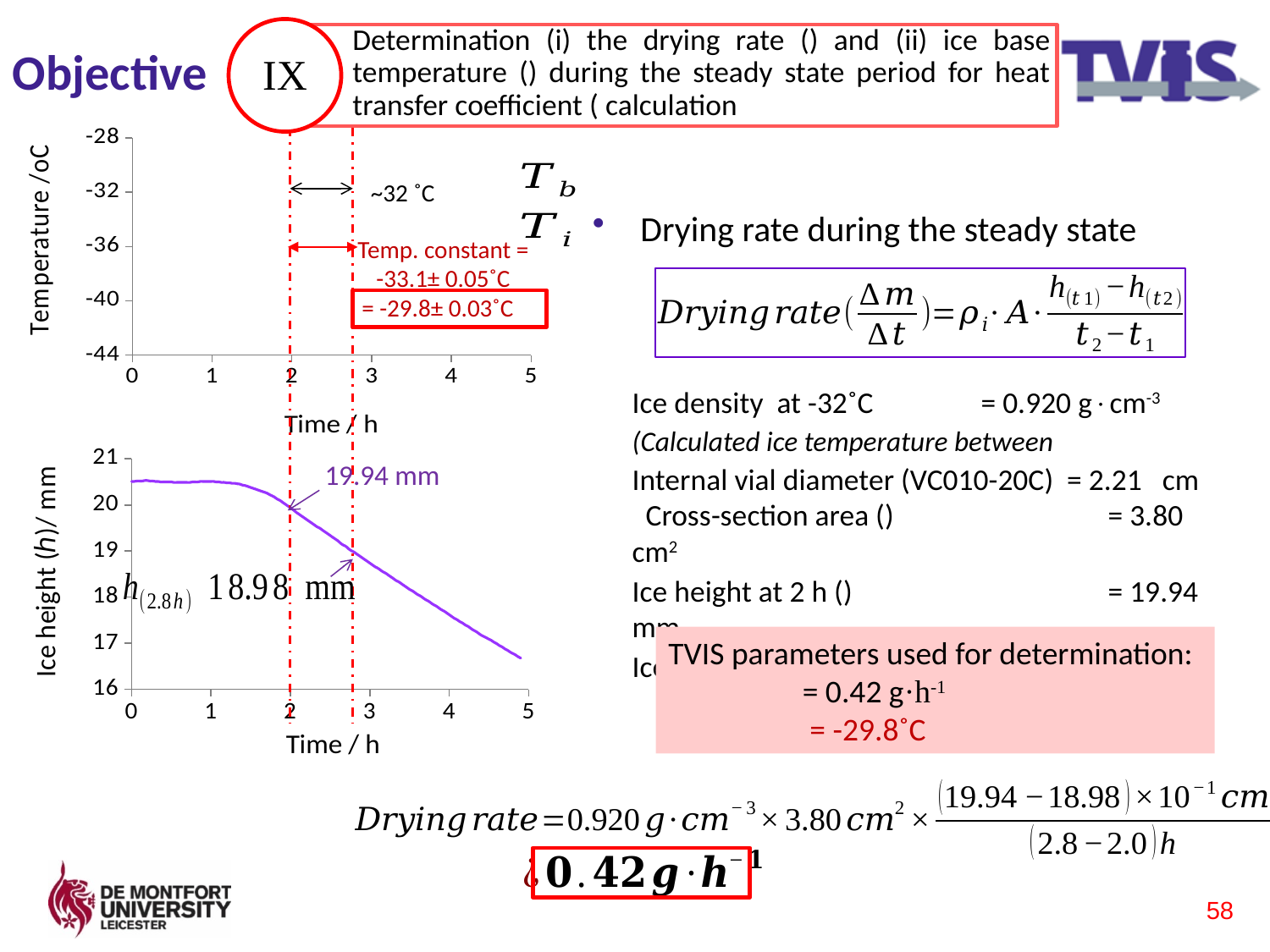
In the bottom chart (Ice height vs Time), is the ice height larger at 2 h or at 2.8 h? 2 h What is the y-axis label of the top chart? Temperature /oC In the bottom chart (Ice height vs Time), is the ice height at 4 h greater or less than 18? less In the bottom chart (Ice height vs Time), what is the ice height at 2 h? 19.94 mm In the bottom chart (Ice height vs Time), is the ice height at 1 h greater or less than 20? greater How many data series are plotted in the bottom chart (Ice height vs Time)? 1 What kind of chart is the bottom chart (Ice height vs Time)? line chart In the bottom chart (Ice height vs Time), what is the ice height at 2.8 h? 18.98 mm What is the y-axis label of the bottom chart? Ice height (h)/ mm In the bottom chart (Ice height vs Time), is the ice height at 3 h greater or less than 18? greater In the bottom chart (Ice height vs Time), does the ice height rise or fall as time increases? fall In the bottom chart (Ice height vs Time), what is the difference between the ice height at 2 h and at 2.8 h? 0.96 mm